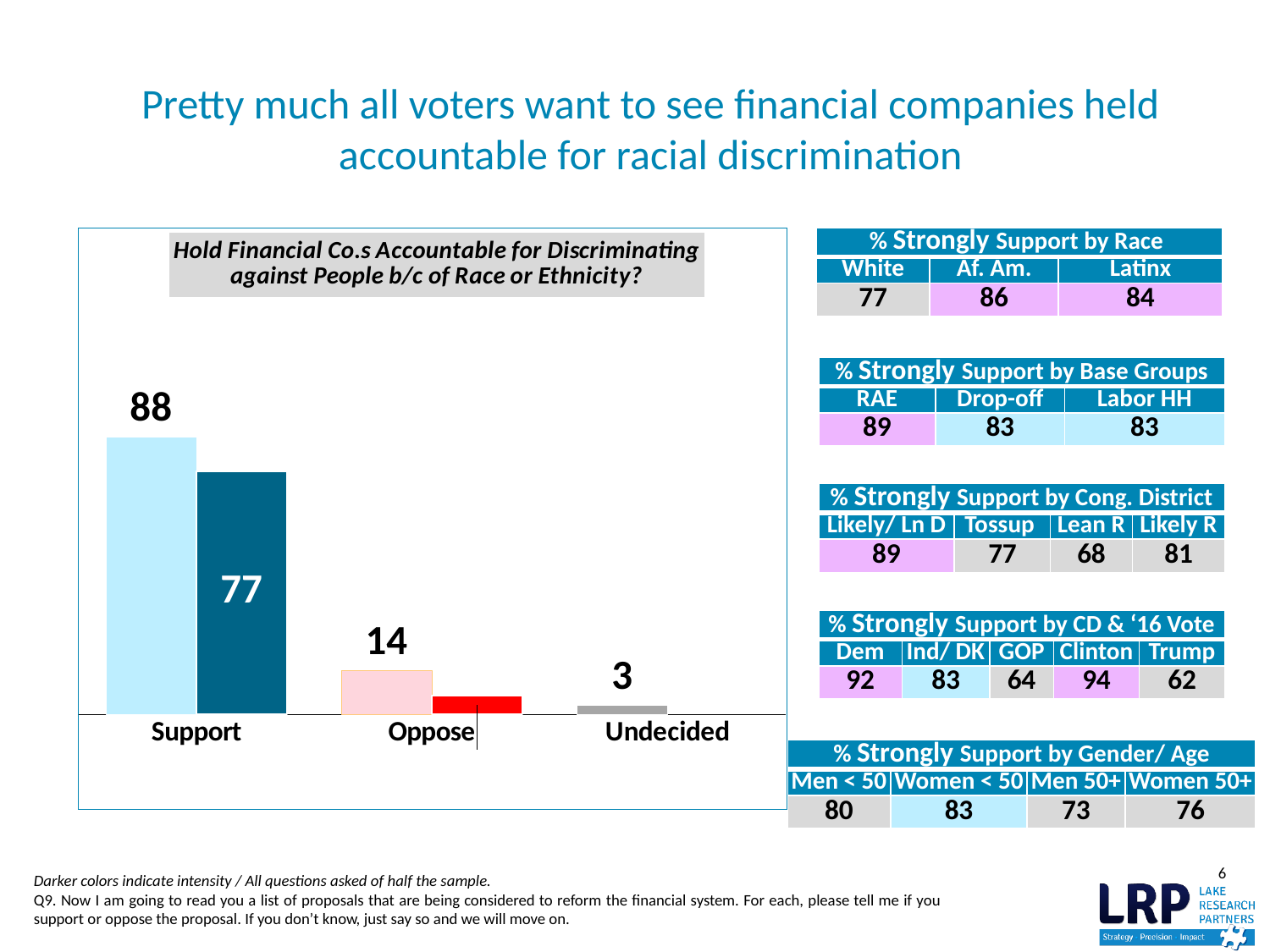
What is the value shown for Undecided in the chart? 3 What kind of chart is shown on the slide? Bar chart Which category has the lowest value in the chart? Undecided What is the difference between the Support value (88) and the Oppose value (14)? 74 Which category has the highest value in the chart? Support How many categories are shown on the x axis of the chart? 3 What is the value shown for Oppose in the chart? 14 What is the value shown for Support in the chart? 88 What value is labeled on the darker bar in the Support category? 77 Do the labeled values fall or rise moving from Support to Undecided along the x axis? Fall What is the difference between the total Support value (88) and the darker Support bar value (77)? 11 Which is larger, the value for Oppose or the value for Undecided? Oppose